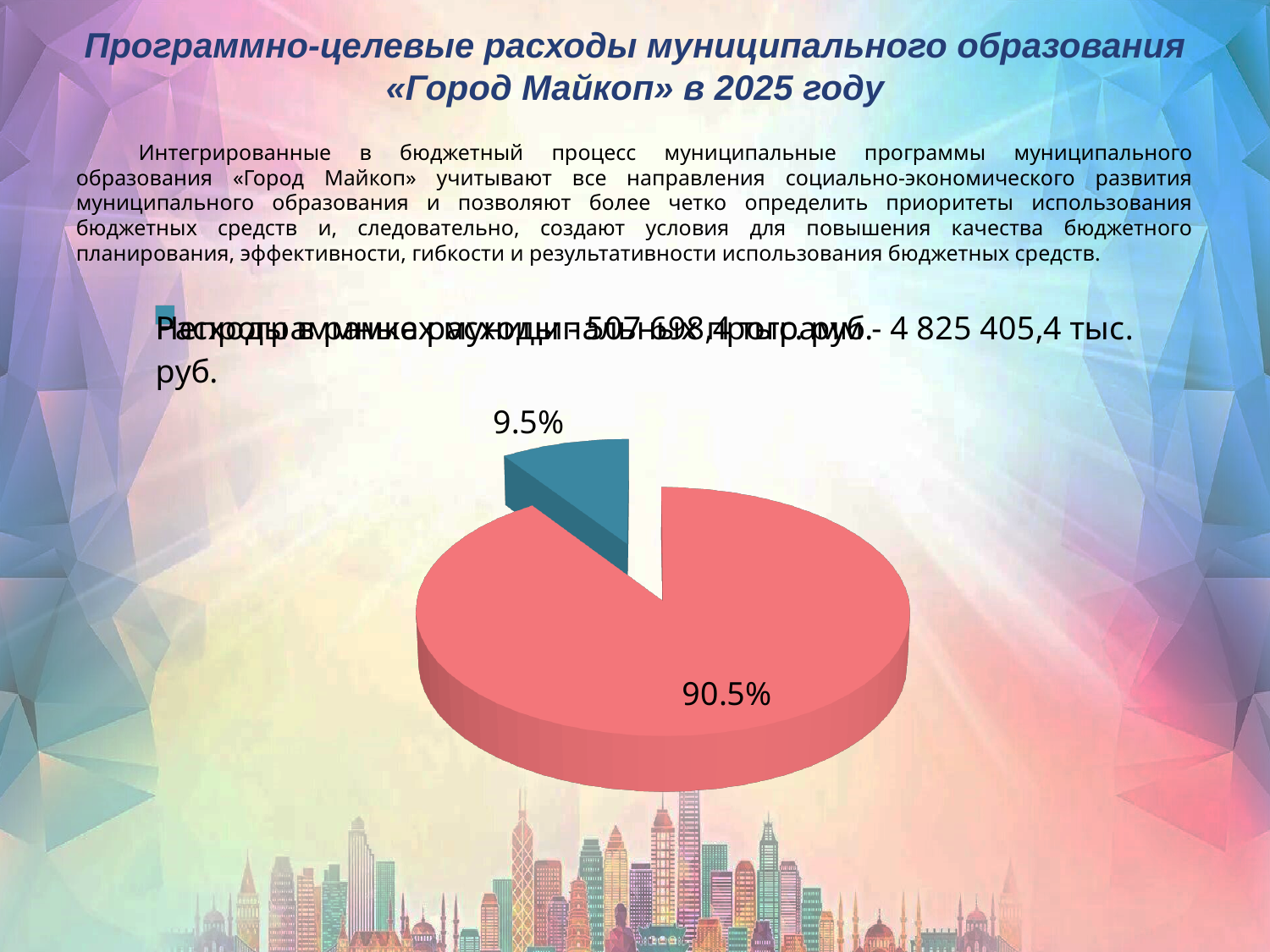
What is the share of the largest slice in the pie chart? 90.5% What do the two slice percentages in the pie chart add up to? 100% What is the share of the smallest slice in the pie chart? 9.5% How many slices does the pie chart have? 2 What colour is the largest slice of the pie chart? red What is the difference in percentage points between the red slice and the teal slice? 81% What percentage is shown for the small teal slice of the pie chart? 9.5% What kind of chart is shown on the slide? pie chart Is the pie chart drawn in 3D or flat 2D? 3D Which slice is larger, the red one or the teal one? the red one What percentage is shown for the large red slice of the pie chart? 90.5%